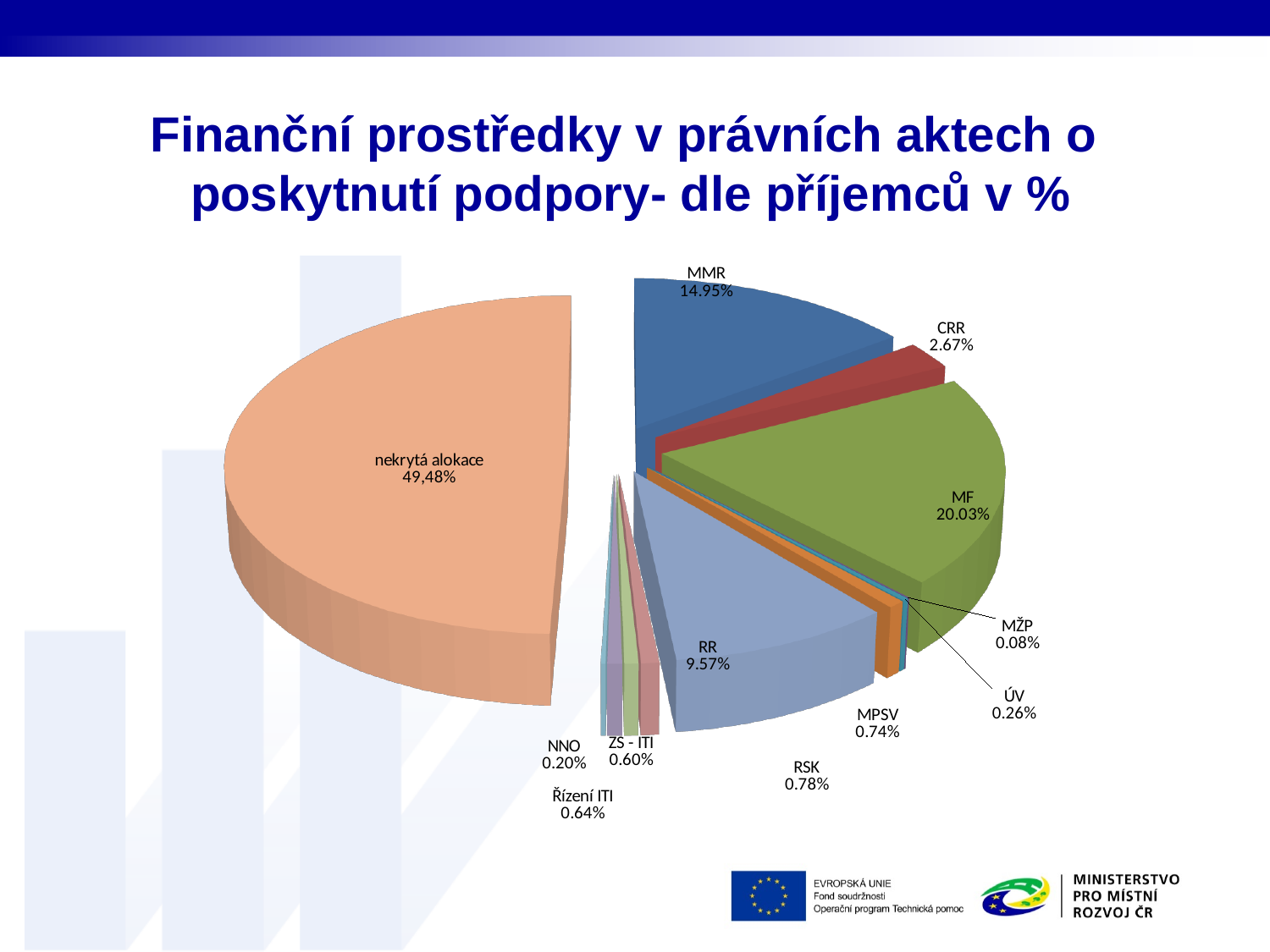
What is the value for MF? 20.03% What is the value for MMR? 14.95% What is the value for MŽP? 0.08% Which is larger, the value for CRR or the value for RR? RR What is the difference between the values for MF and MMR? 5.08% What is the value for RR? 9.57% What is the title of the slide containing the chart? Finanční prostředky v právních aktech o poskytnutí podpory- dle příjemců v % Which category has the smallest slice of the pie? MŽP Which category has the largest slice of the pie? nekrytá alokace What kind of chart is shown on the slide? pie chart What is the value for nekrytá alokace? 49,48% How many slices does the pie chart have? 12